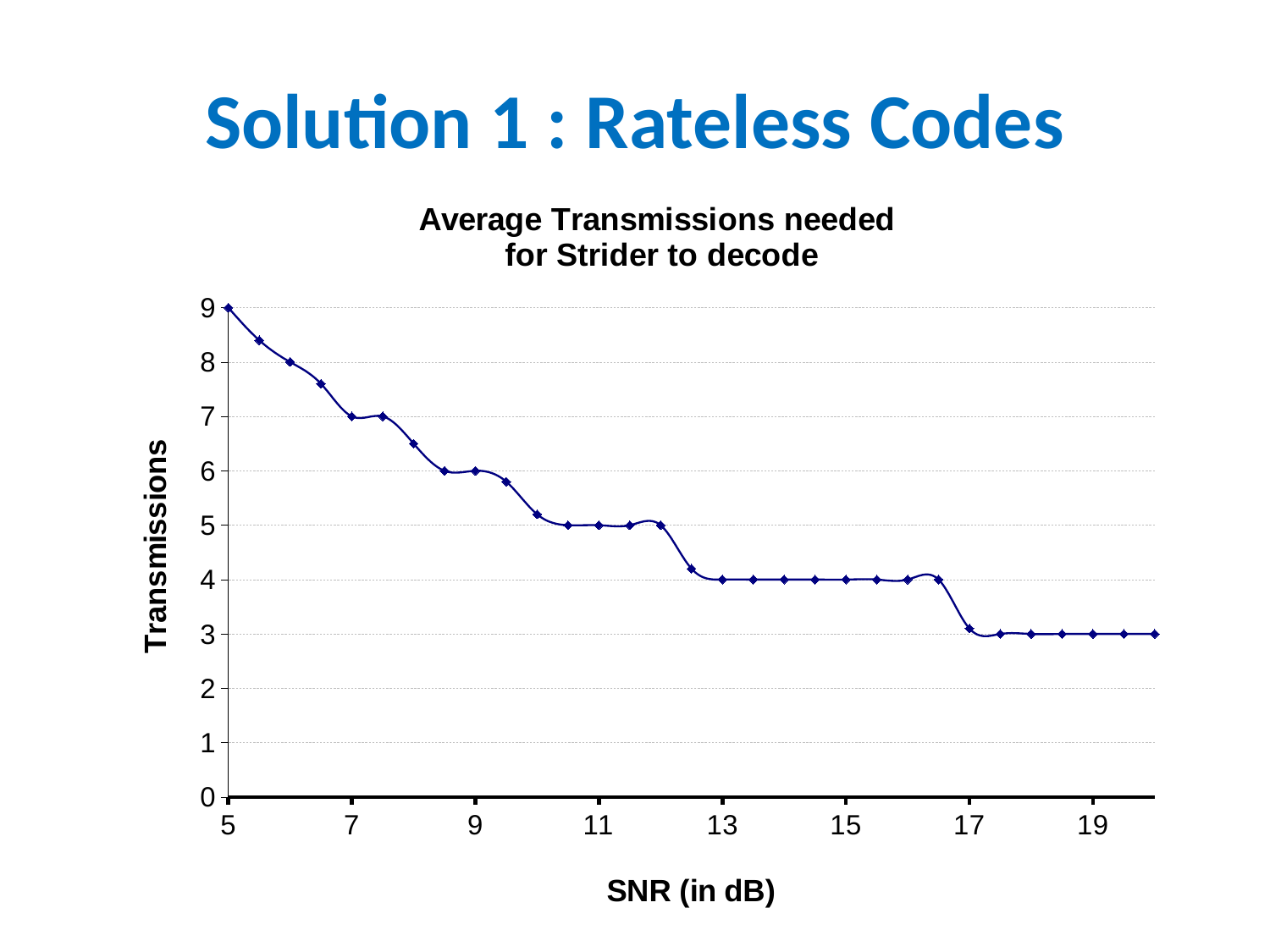
At which SNR value is the number of transmissions highest? 5 What kind of chart is shown on the slide? line chart What is the label of the x axis? SNR (in dB) How many transmissions are needed at an SNR of 5 dB? 9 How many transmissions are needed at an SNR of 13 dB? 4 Is the value at SNR 5.5 dB greater or less than 8? greater How many transmissions are needed at an SNR of 9 dB? 6 Do the transmissions rise or fall as SNR increases? fall What is the title of the chart? Average Transmissions needed for Strider to decode How many transmissions are needed at an SNR of 19 dB? 3 What is the difference in transmissions between SNR 5 dB and SNR 20 dB? 6 How many transmissions are needed at an SNR of 7 dB? 7